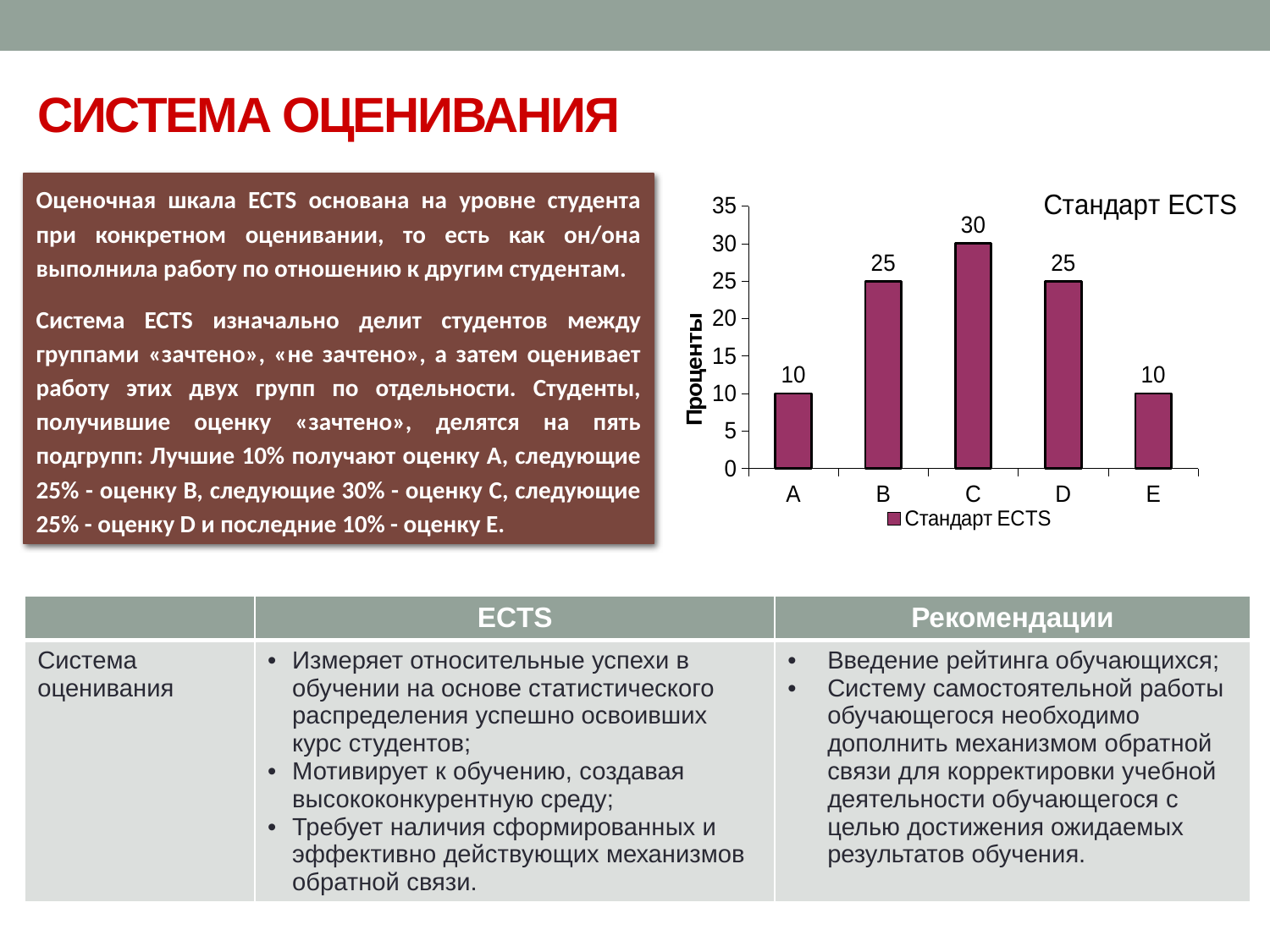
What is the difference between the values for C and B? 5 How many series does the chart legend list? 1 What kind of chart is shown on the slide? Bar chart What is the label of the vertical axis of the chart? Проценты What is the title of the chart? Стандарт ECTS What is the value for category A in the chart? 10 Which is larger, the value for B or the value for A? B Which category has the highest value in the chart? C What is the difference between the values for B and E? 15 What is the value for category C in the chart? 30 What is the value for category D in the chart? 25 How many categories are shown on the x axis of the chart? 5